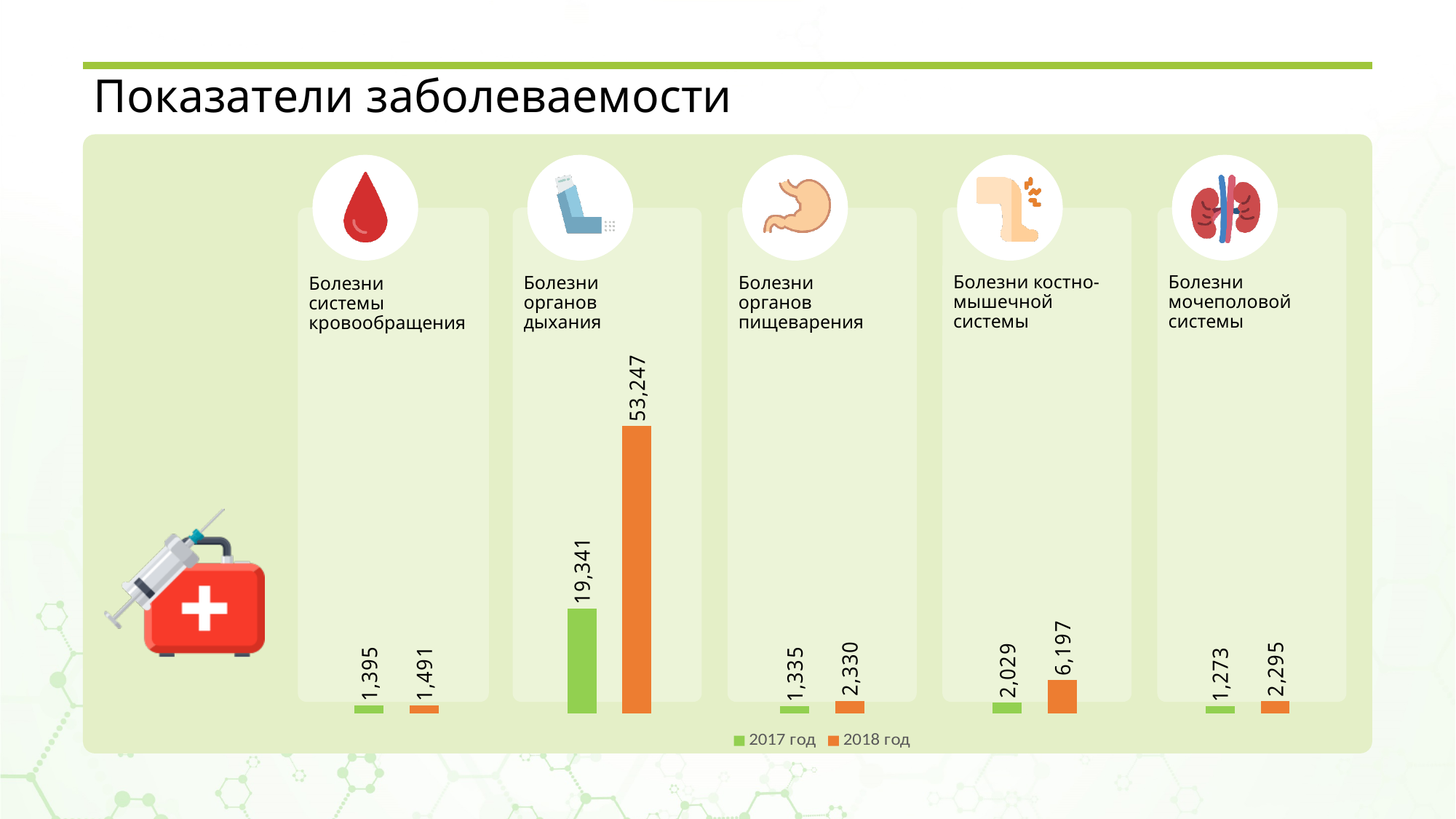
How many series does the legend list? 2 What is the title of the slide? Показатели заболеваемости What is the difference between the 2018 год and 2017 год values for Болезни костно-мышечной системы? 4,168 What is the 2018 год value for Болезни органов дыхания? 53,247 Which category has the lowest 2017 год value? Болезни мочеполовой системы How many disease categories are shown in the chart? 5 Which category has the highest 2018 год value? Болезни органов дыхания What is the 2017 год value for Болезни костно-мышечной системы? 2,029 What is the difference between the 2018 год and 2017 год values for Болезни органов дыхания? 33,906 What is the 2018 год value for Болезни мочеполовой системы? 2,295 What kind of chart is shown on the slide? Bar chart Which is larger: the 2018 год value for Болезни органов пищеварения or the 2018 год value for Болезни мочеполовой системы? Болезни органов пищеварения